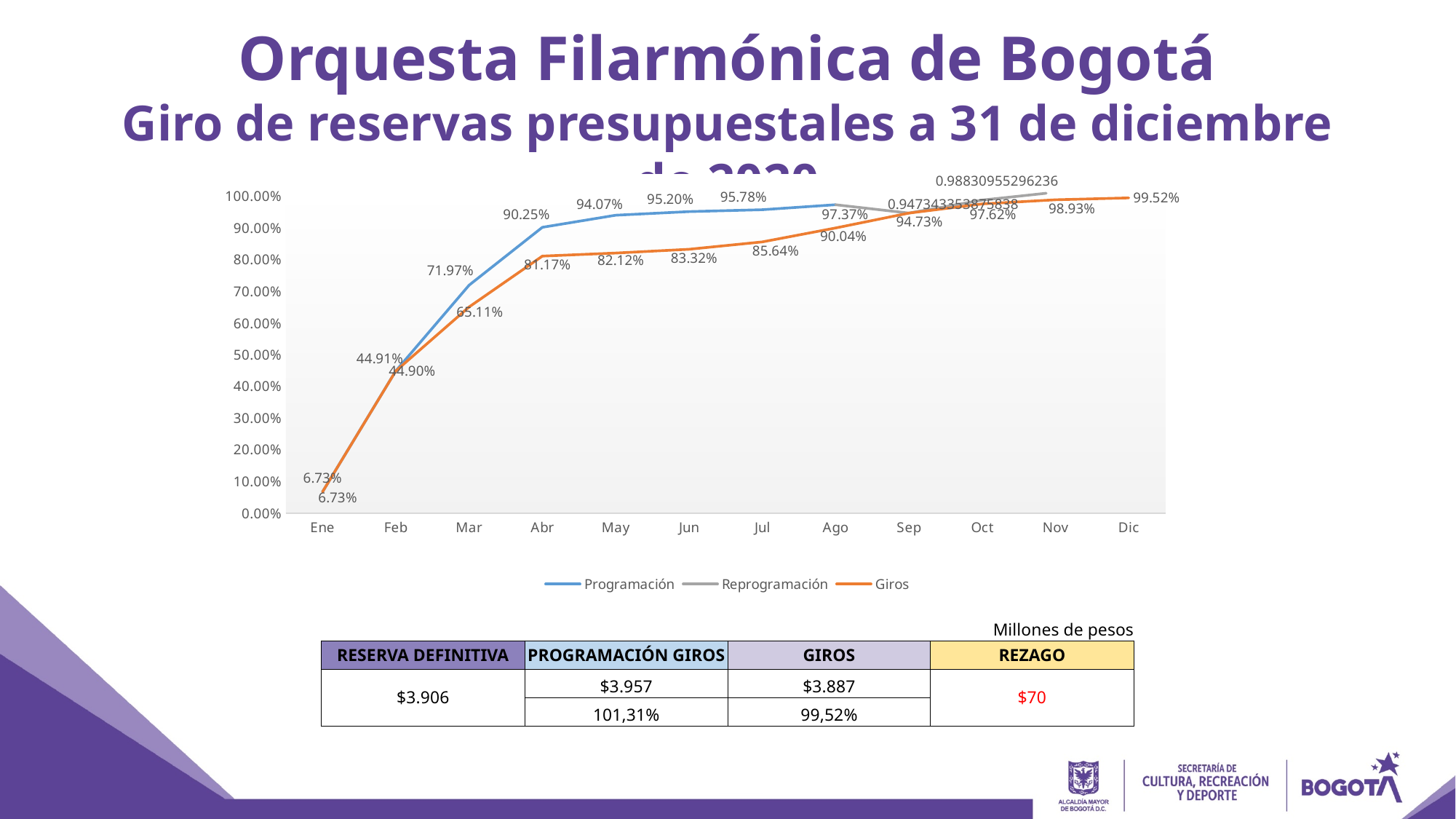
What is the Giros value for Ago? 90.04% How many months are shown on the x axis of the chart? 12 Do the Giros values rise or fall from Ene to Dic? rise In which month is the Giros value lowest? Ene What kind of chart is shown on the slide? line chart In Abr, which is larger: the Programación value or the Giros value? Programación In which month is the Giros value highest? Dic What is the Programación value for Abr? 90.25% What is the Giros value for Dic? 99.52% What is the Giros value for Mar? 65.11% How many series does the chart legend list? 3 What is the difference between the Programación value and the Giros value in Mar? 6.86 percentage points